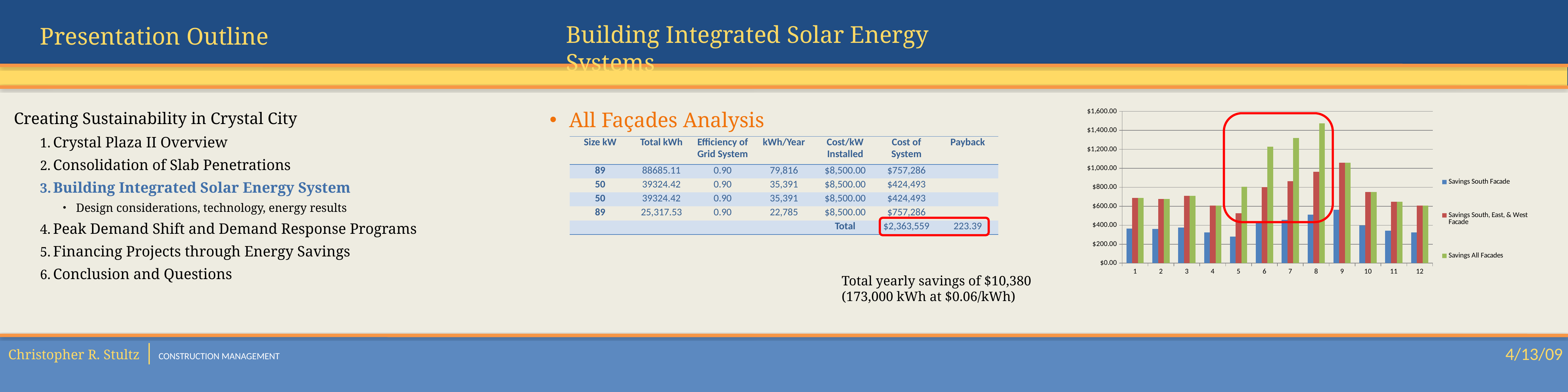
In the bar chart, is the value for Savings South, East, & West Facade at category 9 greater or less than $800.00? greater How many categories are shown along the x axis of the bar chart? 12 In the bar chart at category 1, which is larger: Savings South Facade or Savings All Facades? Savings All Facades In the bar chart, is the value for Savings South Facade at category 5 greater or less than $400.00? less In the bar chart, do the values for Savings All Facades rise or fall from category 8 to category 12? fall In the bar chart, which category has the highest value for Savings All Facades? 8 In the bar chart, is the value for Savings All Facades at category 8 greater or less than $1,200.00? greater In the bar chart, which category has the lowest value for Savings South Facade? 5 What are the three series names listed in the legend of the bar chart? Savings South Facade; Savings South, East, & West Facade; Savings All Facades In the bar chart at category 7, which is larger: Savings All Facades or Savings South, East, & West Facade? Savings All Facades What kind of chart is shown on the right side of the slide? bar chart How many series does the legend of the bar chart list? 3